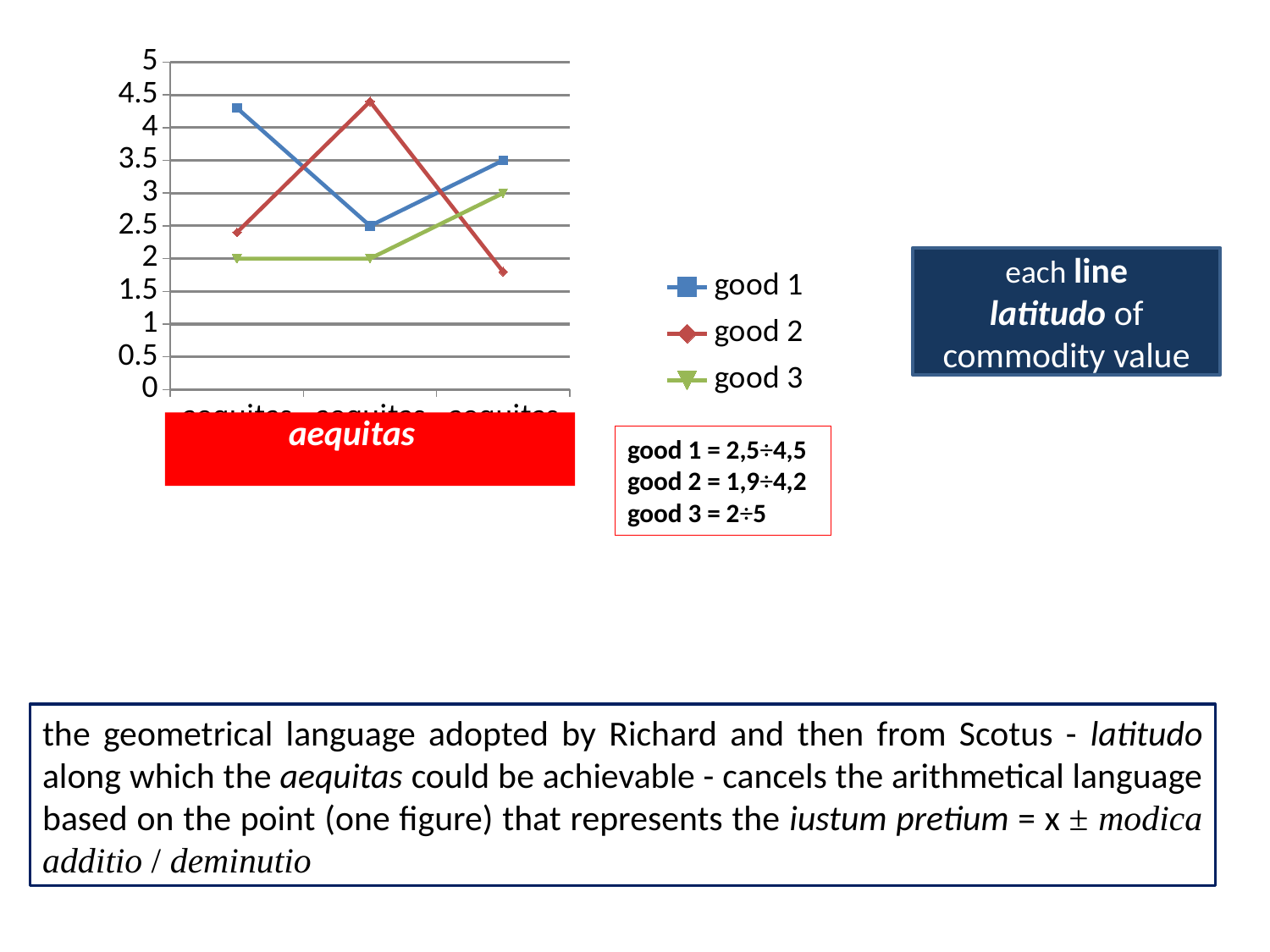
By how much does good 1 increase from the second point to the third point? 1 What are the legend entries of the chart? good 1, good 2, good 3 What kind of chart is shown on the slide? line chart What is the value of good 1 at the third point on the x axis? 3.5 What is the value of good 1 at the second point on the x axis? 2.5 What is the value of good 3 at the third point on the x axis? 3 What is the value of good 3 at the first point on the x axis? 2 Is the value of good 2 at the second point greater or less than 4? greater Which series has the highest value at the second point on the x axis? good 2 Is the value of good 2 at the third point greater or less than 2? less How many series does the chart's legend list? 3 How many points does each line in the chart have? 3